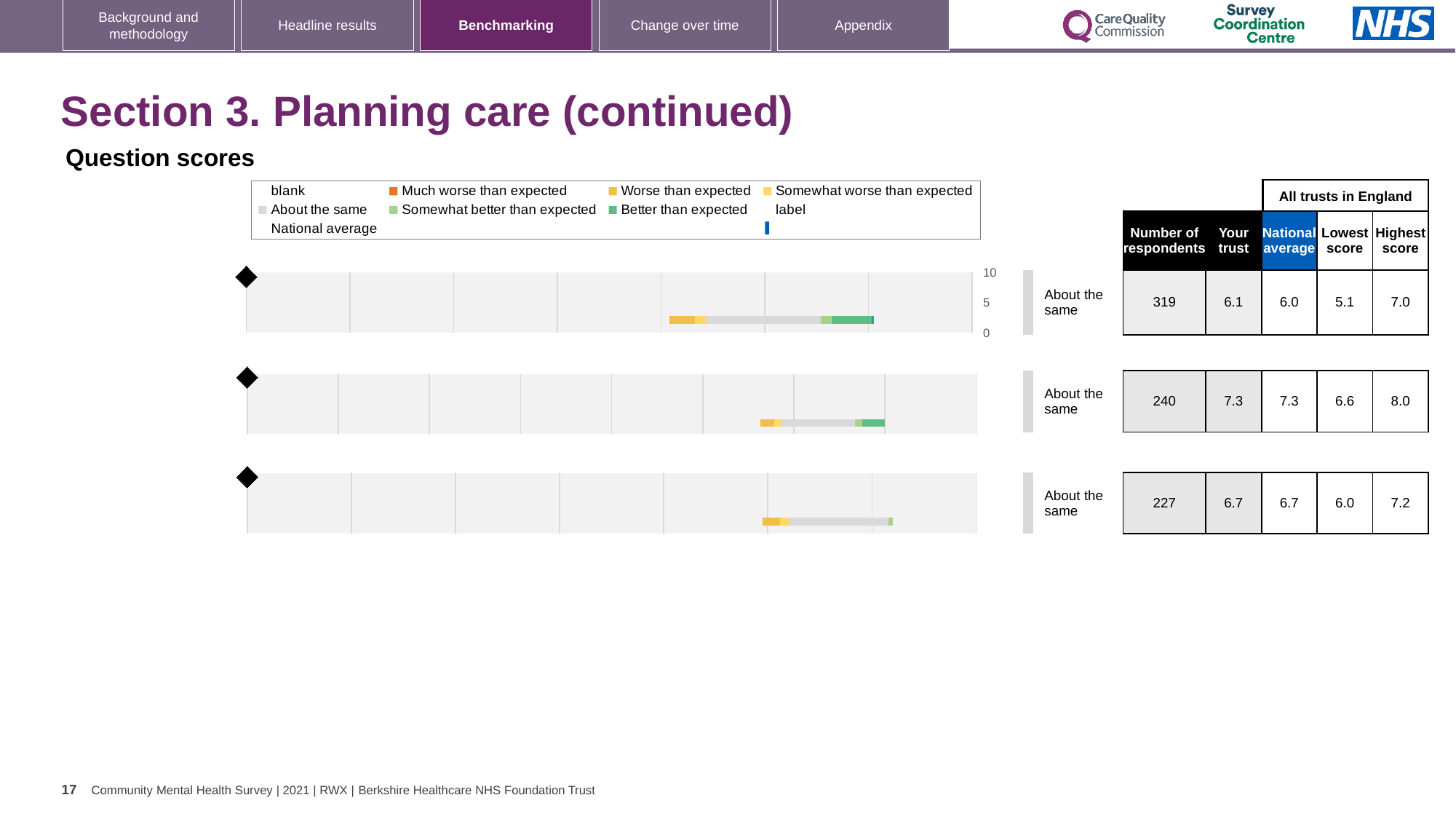
Which of the three charts has the highest 'Your trust' score? the middle chart For the bottom chart, how many respondents are there? 227 For the top chart, what is the 'Your trust' score? 6.1 For the middle chart, what is the national average score? 7.3 What kind of chart is used to show the question scores on this slide? bar chart For the top chart, which is larger: the 'Your trust' score or the national average? Your trust For the top chart, is the 'Your trust' score greater or less than 5? greater What benchmark category is shown next to each of the three charts? About the same For the top chart, what is the difference between the highest score and the lowest score? 1.9 For the middle chart, what is the difference between the 'Your trust' score and the lowest score? 0.7 For the bottom chart, what is the lowest score among all trusts in England? 6.0 How many question score charts are shown on the slide? 3